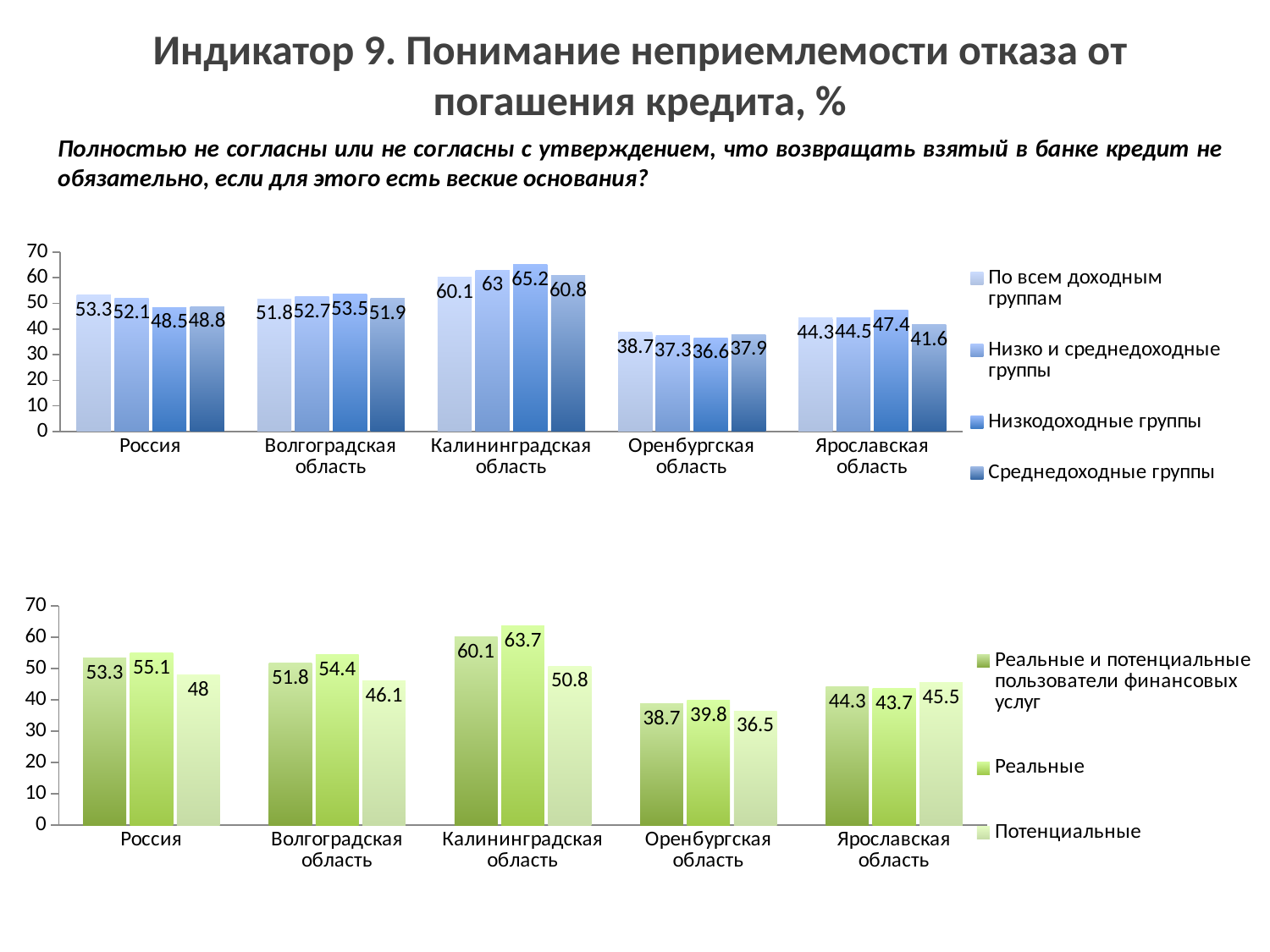
In the bottom chart, what is the difference between Реальные и потенциальные пользователи финансовых услуг and Потенциальные in Волгоградская область? 5.7 How many series does the legend of the top chart list? 4 In the top chart, what is the value for Среднедоходные группы in Ярославская область? 41.6 In the top chart, what is the value for Низкодоходные группы in Калининградская область? 65.2 In the bottom chart, what is the value for Реальные in Оренбургская область? 39.8 In the bottom chart, what is the difference between Реальные and Потенциальные in Калининградская область? 12.9 How many regions are shown on the x axis of the bottom chart? 5 In the top chart, which is larger in Россия: По всем доходным группам or Низкодоходные группы? По всем доходным группам In the bottom chart, what is the value for Потенциальные in Россия? 48 In the top chart, which region has the lowest value for По всем доходным группам? Оренбургская область In the bottom chart, which region has the highest value for Реальные? Калининградская область What kind of chart is the bottom chart? Bar chart